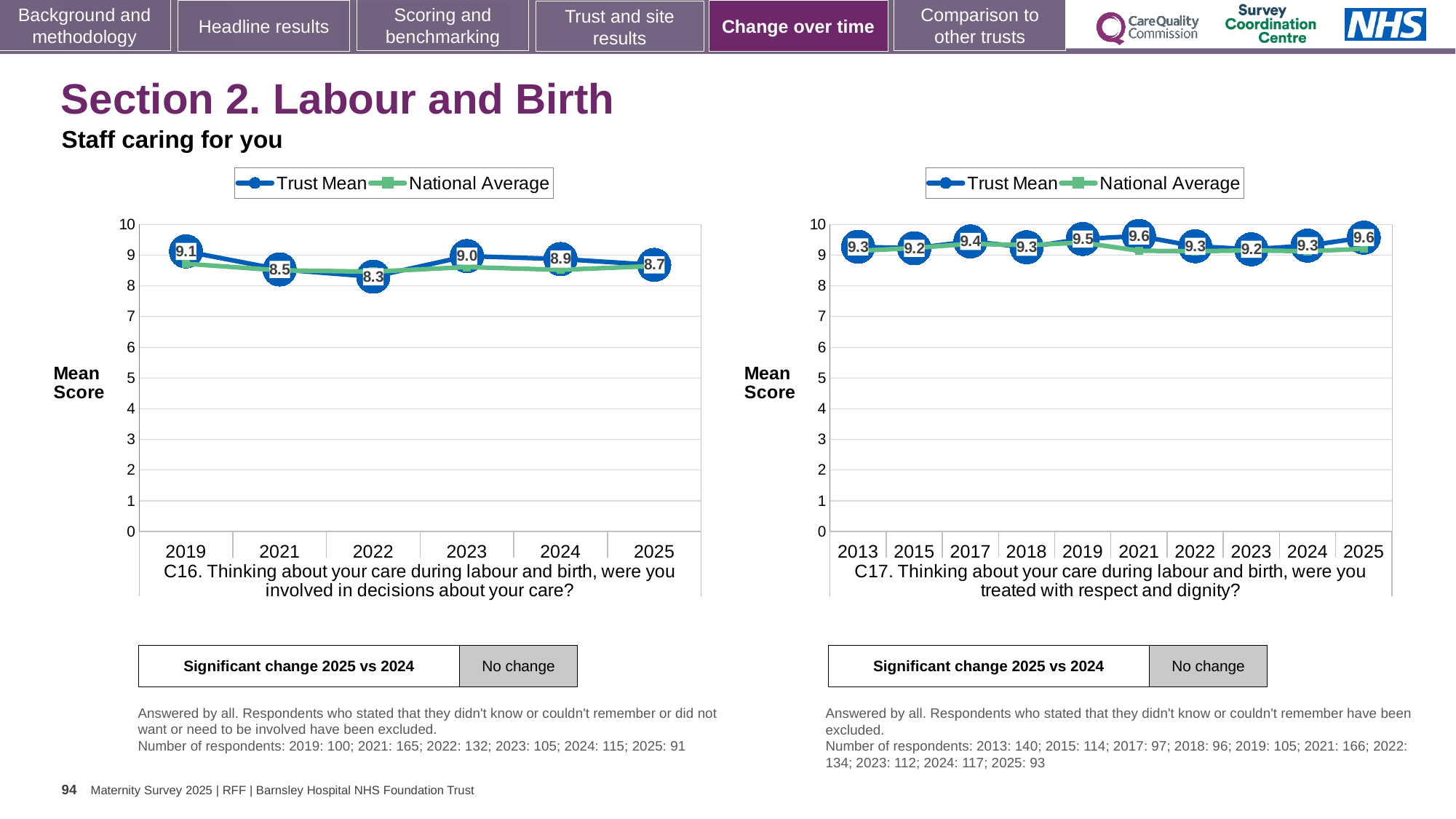
In the C17 chart on the right, what is the Trust Mean for 2013? 9.3 In the C16 chart on the left, what is the Trust Mean for 2019? 9.1 How many series does the legend of the C16 chart on the left list? 2 In the C16 chart on the left, what is the difference between the Trust Mean for 2019 and for 2022? 0.8 In the C16 chart on the left, which year has the lowest Trust Mean? 2022 In the C16 chart on the left, which year has the highest Trust Mean? 2019 In the C16 chart on the left, what is the Trust Mean for 2022? 8.3 In the C17 chart on the right, what is the Trust Mean for 2025? 9.6 In the C16 chart on the left, is the Trust Mean for 2023 or for 2025 larger? 2023 In the C17 chart on the right, what is the difference between the Trust Mean for 2025 and for 2024? 0.3 In the C16 chart on the left, is the National Average for 2019 greater or less than 8? greater How many years are plotted in the C17 chart on the right? 10